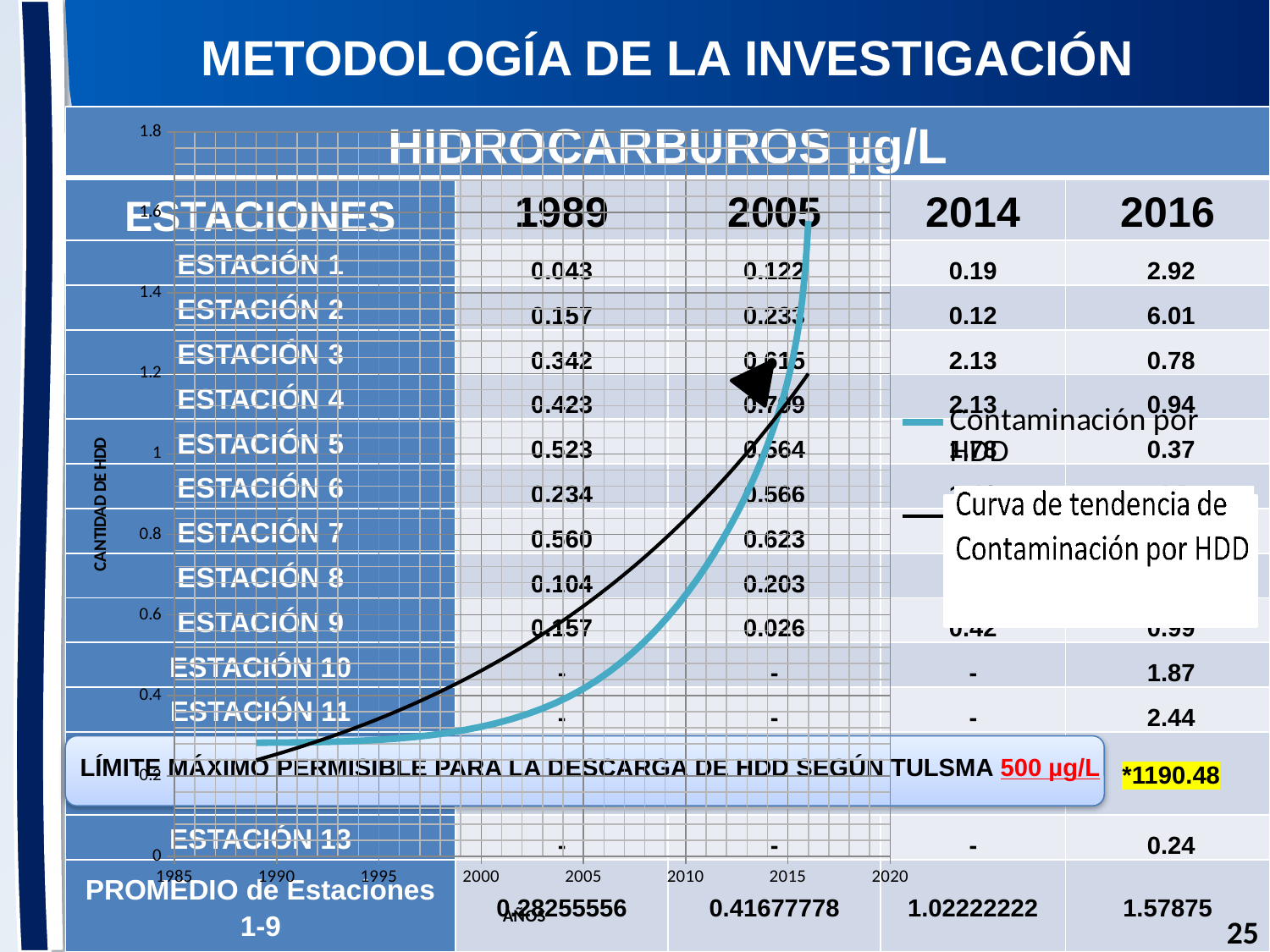
Which series is drawn in black on the chart? Curva de tendencia de Contaminación por HDD What kind of chart is overlaid on the table on this slide? Line chart What is the title of the chart's vertical axis? CANTIDAD DE HDD Is the value of the Contaminación por HDD line at 2010 greater or less than 0.4? greater Do the values of the Contaminación por HDD line rise or fall as the years increase along the x axis? Rise What is the title of the chart's horizontal axis? AÑOS Is the value of the Contaminación por HDD line at 2000 greater or less than 0.6? less How many series does the chart's legend list? 2 Is the value of the Contaminación por HDD line at 2015 greater or less than 1? greater